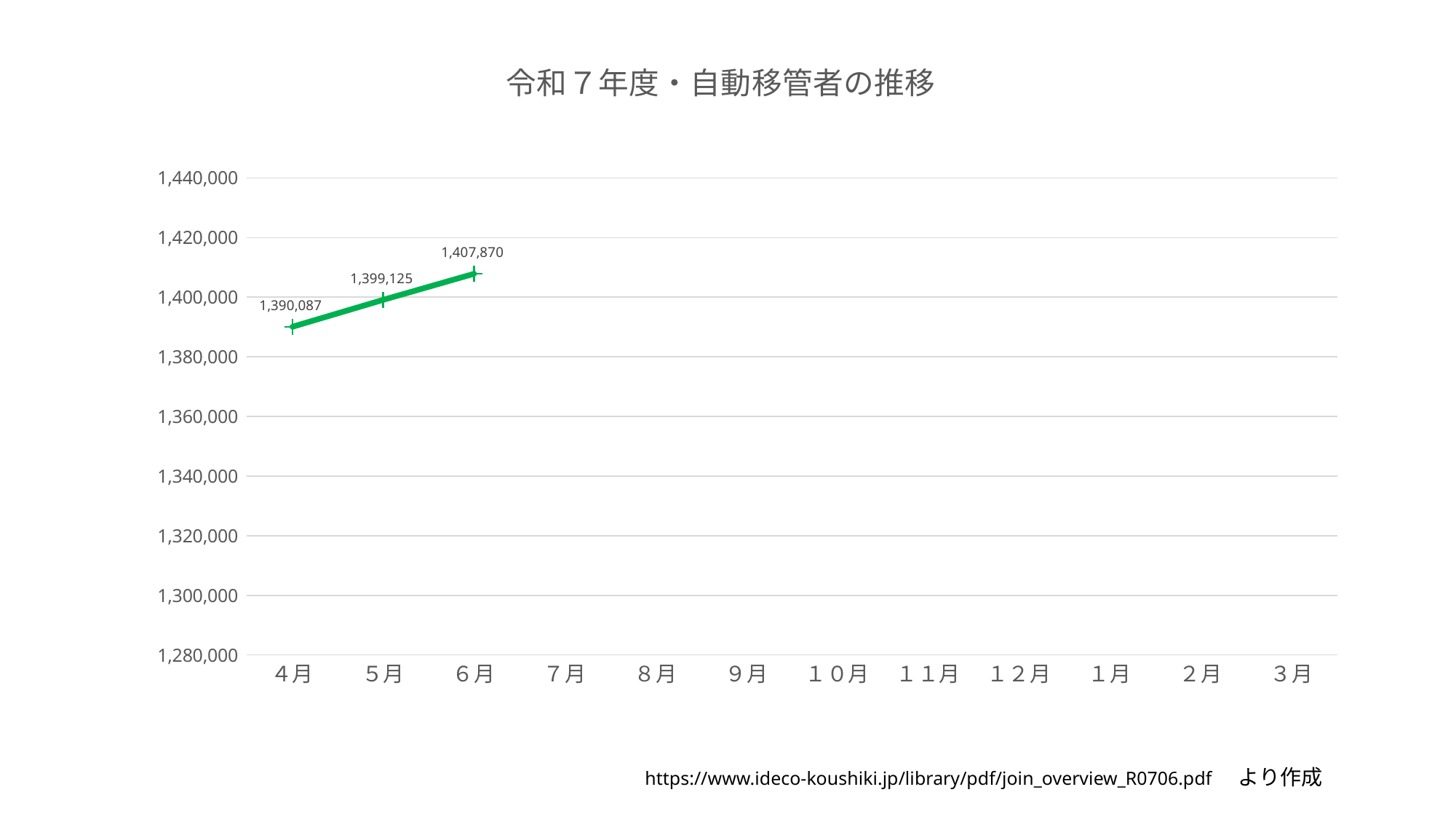
How many data points are plotted on the line? 3 What is the difference between the values for 5月 and 4月? 9,038 Which month has the highest plotted value? 6月 Which month has the lowest plotted value? 4月 What kind of chart is shown? line chart What is the difference between the values for 6月 and 4月? 17,783 Do the plotted values rise or fall from 4月 to 6月? rise What is the value for 6月? 1,407,870 What is the value for 4月? 1,390,087 What is the value for 5月? 1,399,125 Is the value for 4月 greater or less than 1,400,000? less Which is larger, the value for 5月 or the value for 6月? 6月